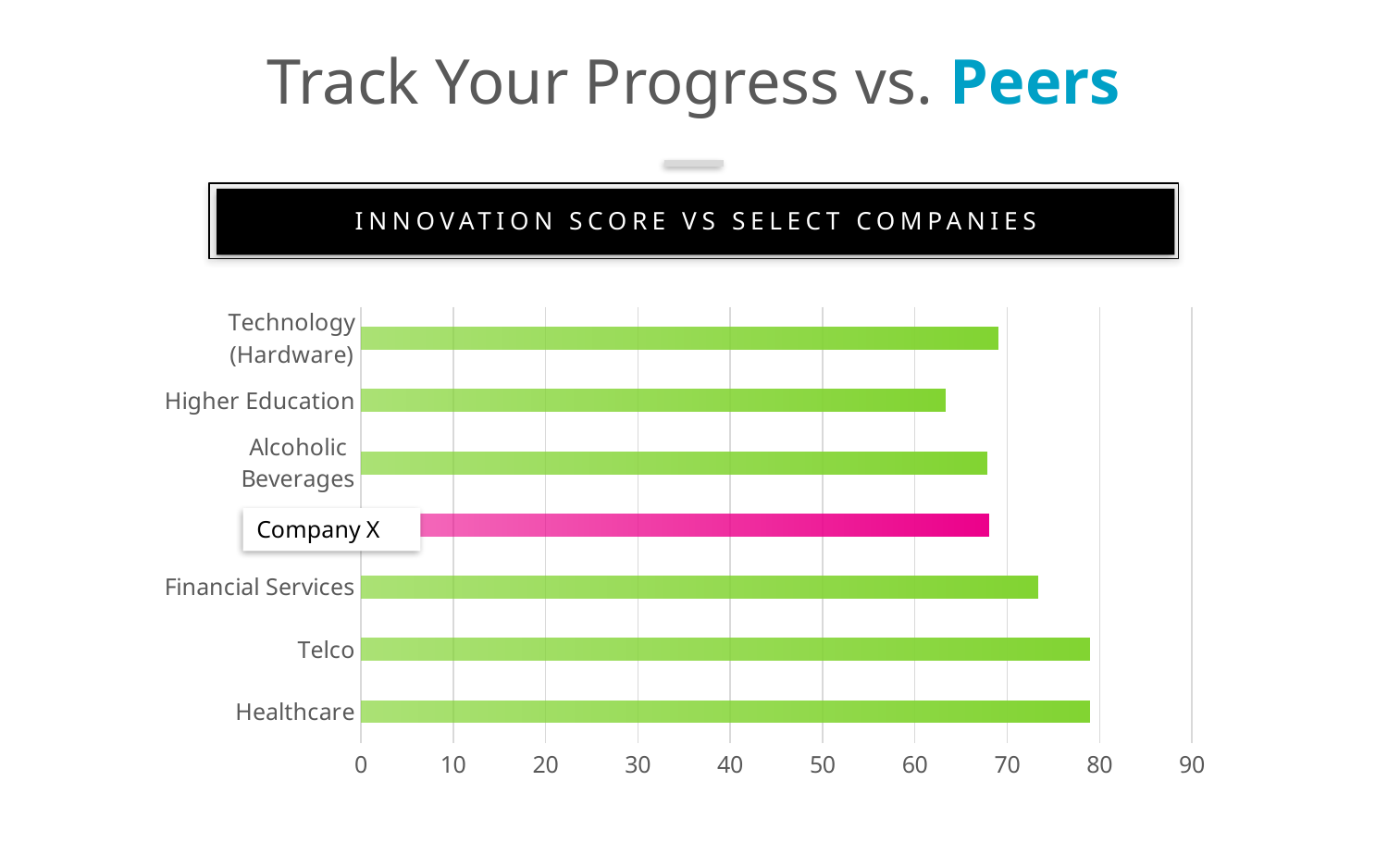
Which has a higher innovation score, Telco or Higher Education? Telco What is the title of the chart? Innovation Score vs Select Companies What kind of chart is shown on the slide? bar chart Which category's bar is highlighted in pink rather than green? Company X Is the value for Telco greater or less than 70? greater Which has a higher innovation score, Financial Services or Company X? Financial Services Is the value for Financial Services greater or less than 70? greater Which category has the lowest innovation score? Higher Education Is the value for Company X greater or less than 60? greater How many categories (bars) does the chart show? 7